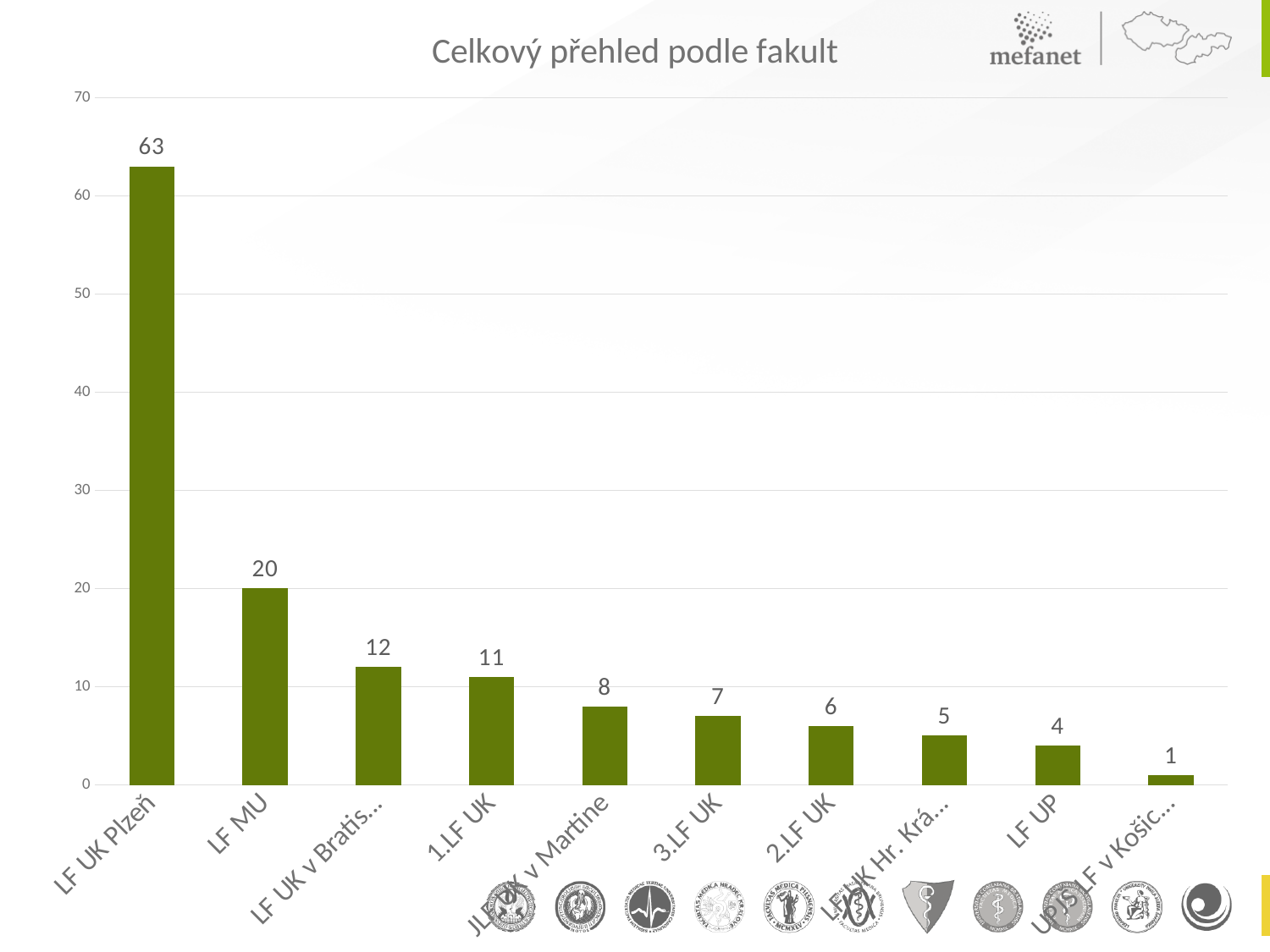
What kind of chart is shown on the slide? bar chart What is the value for LF UK Plzeň? 63 What is the value for LF UP? 4 Is the value for LF MU greater or less than 30? less Which has a larger value, 2.LF UK or 3.LF UK? 3.LF UK What is the title of the chart? Celkový přehled podle fakult Which faculty has the highest value? LF UK Plzeň What is the difference between the values for LF UK Plzeň and LF MU? 43 What is the value for 3.LF UK? 7 What is the value for 1.LF UK? 11 What is the value for LF MU? 20 How many faculties are shown in the chart? 10